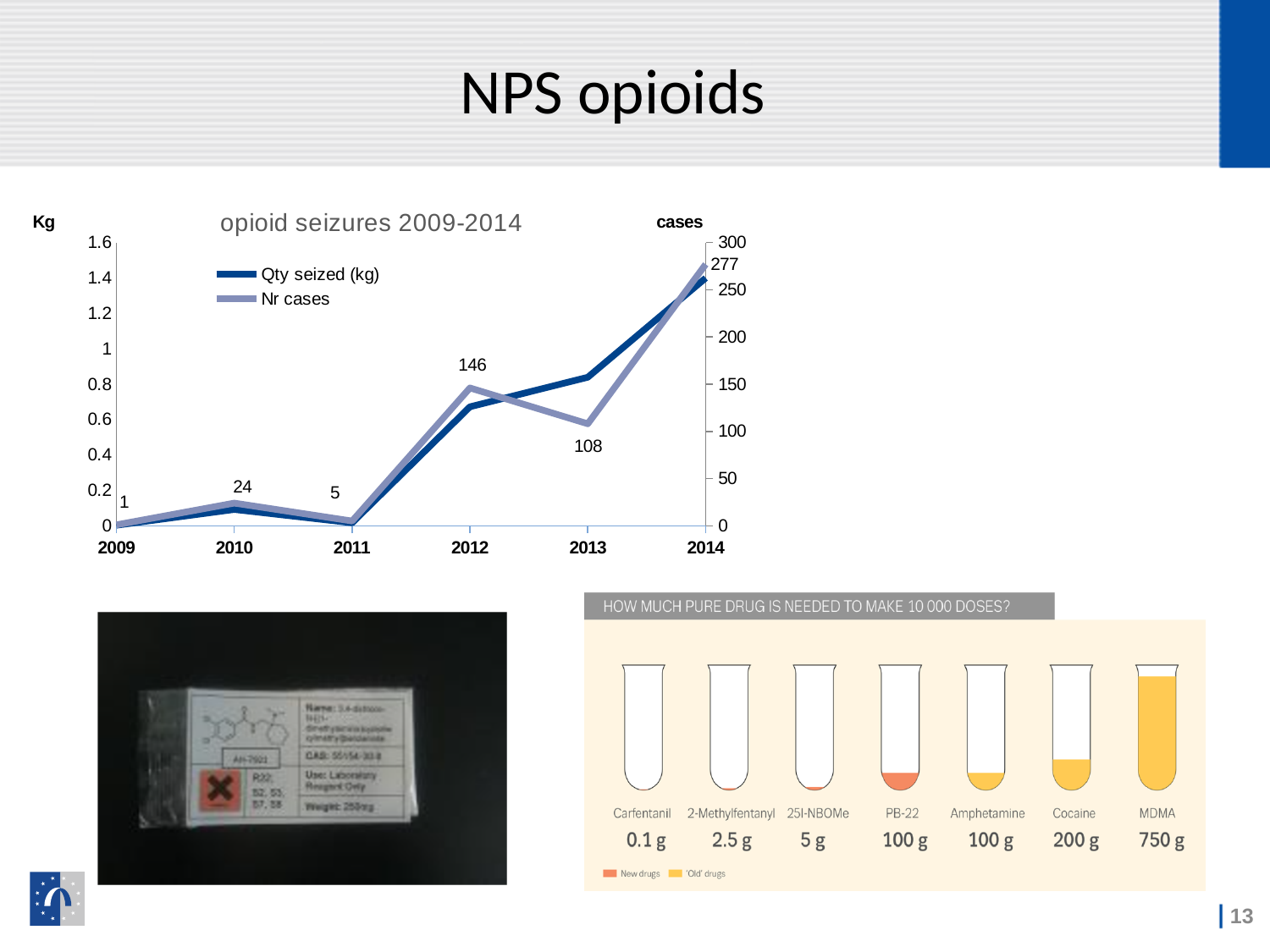
In the 'opioid seizures 2009-2014' chart, does the number of cases rise or fall from 2012 to 2013? fall In the bottom-right graphic 'How much pure drug is needed to make 10 000 doses?', how much MDMA is needed? 750 g In the 'opioid seizures 2009-2014' chart, how many years are plotted on the x axis? 6 In the 'opioid seizures 2009-2014' chart, what is the number of cases in 2012? 146 In the 'opioid seizures 2009-2014' chart, what is the difference in number of cases between 2014 and 2013? 169 In the 'opioid seizures 2009-2014' chart, what is the number of cases in 2010? 24 In the 'opioid seizures 2009-2014' chart, how many series does the legend list? 2 In the 'opioid seizures 2009-2014' chart, which year has the lowest number of cases? 2009 In the 'opioid seizures 2009-2014' chart, is the quantity seized (kg) in 2014 greater or less than 1.2? greater In the 'opioid seizures 2009-2014' chart, what is the number of cases in 2014? 277 In the 'opioid seizures 2009-2014' chart, which year has more cases, 2012 or 2013? 2012 What type of chart is 'opioid seizures 2009-2014'? line chart